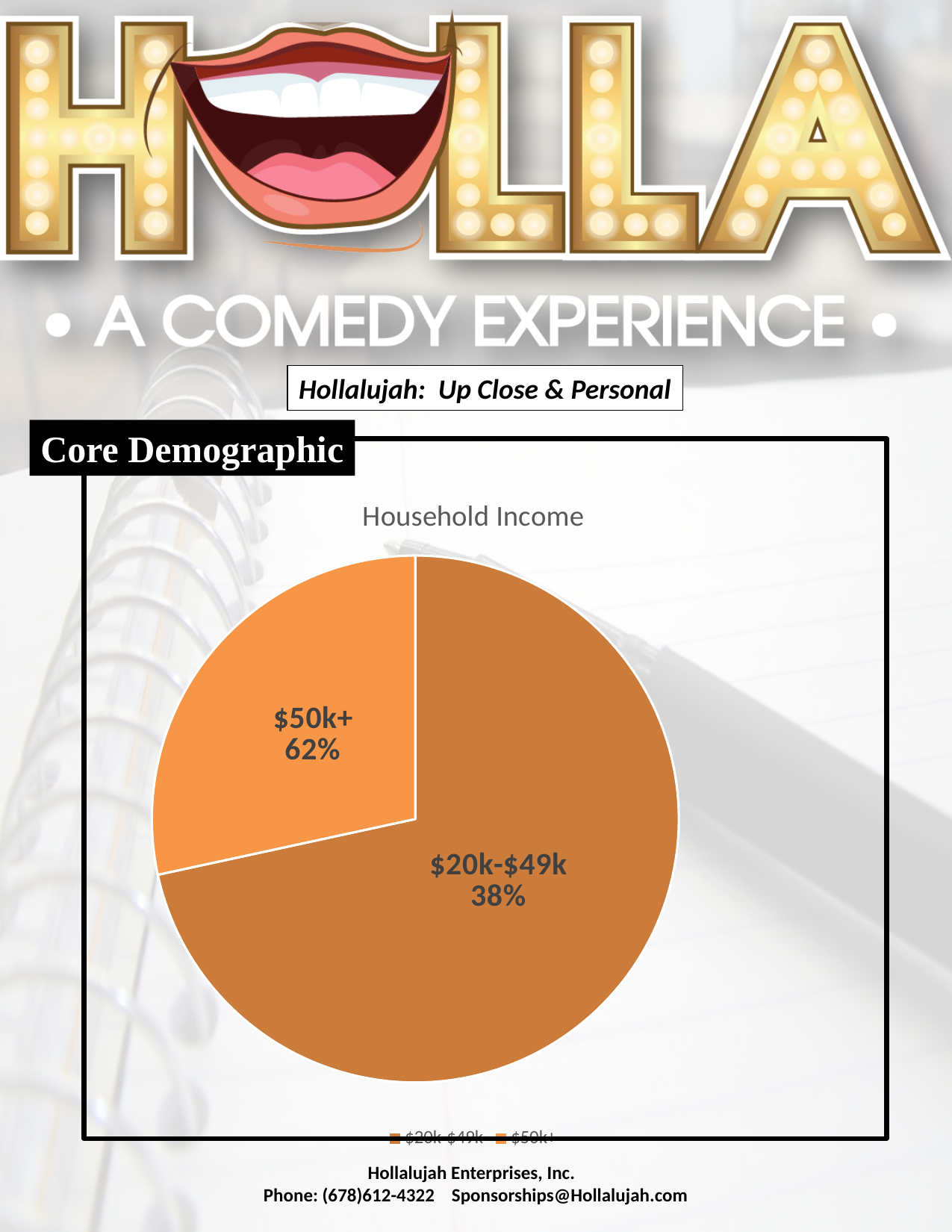
What type of chart is shown on the slide? pie chart What is the title of the chart? Household Income According to the data labels, which category has the lower percentage in the Household Income chart? $20k-$49k What share of the pie does the $20k-$49k label indicate? 38% What percentage is shown for the $20k-$49k category in the Household Income chart? 38% According to the data labels, which category has the higher percentage in the Household Income chart? $50k+ What percentage is shown for the $50k+ category in the Household Income chart? 62% How many categories are shown in the Household Income pie chart? 2 According to the data labels, is the percentage for $50k+ larger or smaller than the percentage for $20k-$49k? larger What is the difference in percentage points between the $50k+ label and the $20k-$49k label in the Household Income chart? 24 percentage points What is the heading in the black box above the chart? Core Demographic